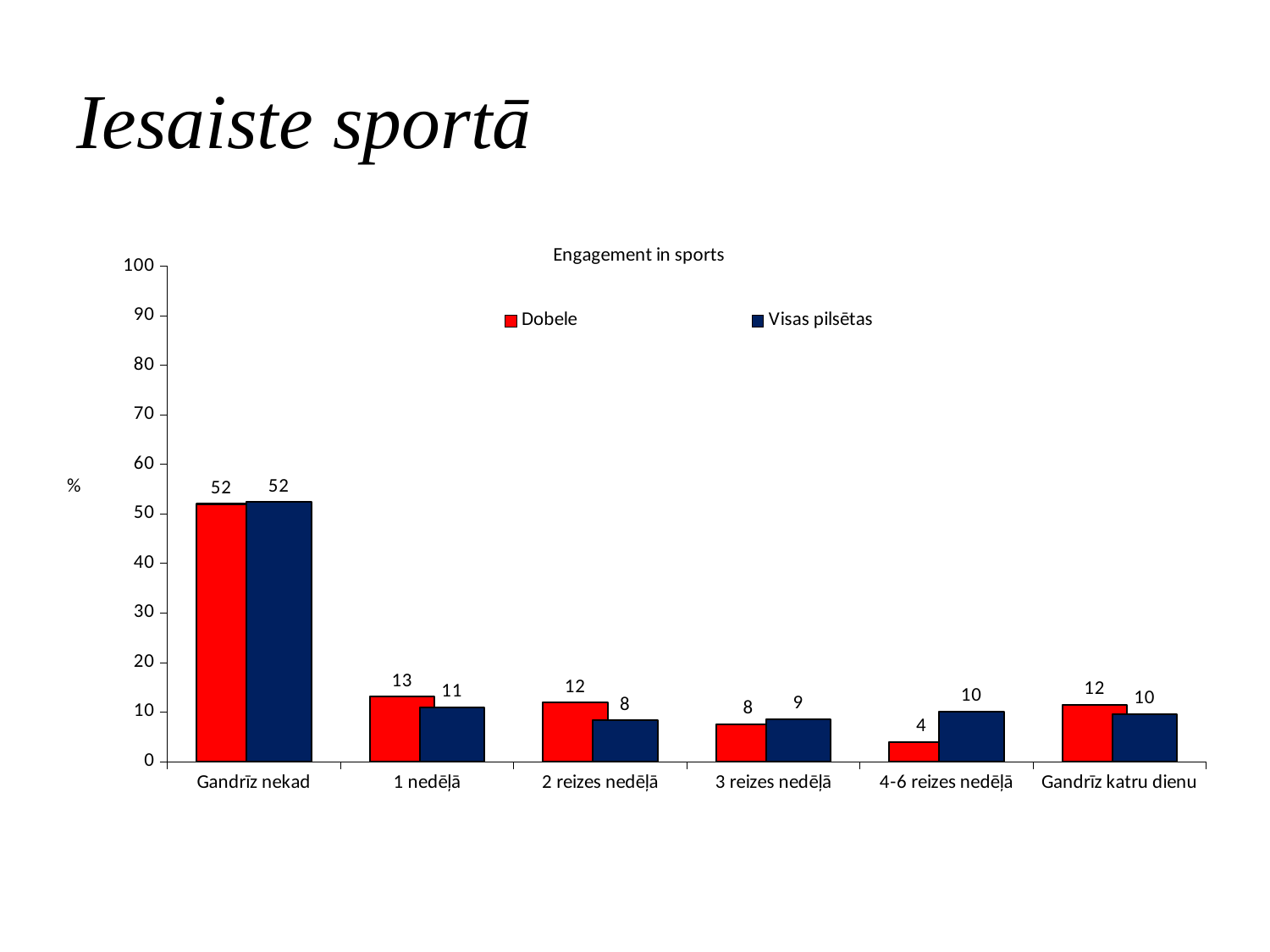
What is the difference between Dobele and Visas pilsētas in the '2 reizes nedēļā' category? 4 Is the value for Dobele in the 'Gandrīz nekad' category greater or less than 50? greater What is the value for Visas pilsētas in the '4-6 reizes nedēļā' category? 10 Which category has the lowest value for Dobele? 4-6 reizes nedēļā What is the value for Dobele in the '1 nedēļā' category? 13 How many categories are shown on the x axis? 6 How many series does the legend list? 2 What is the title of the chart? Engagement in sports Which category has the highest value for Dobele? Gandrīz nekad What is the value for Dobele in the 'Gandrīz nekad' category? 52 In the '4-6 reizes nedēļā' category, which series has the larger value, Dobele or Visas pilsētas? Visas pilsētas What kind of chart is shown on the slide? Bar chart